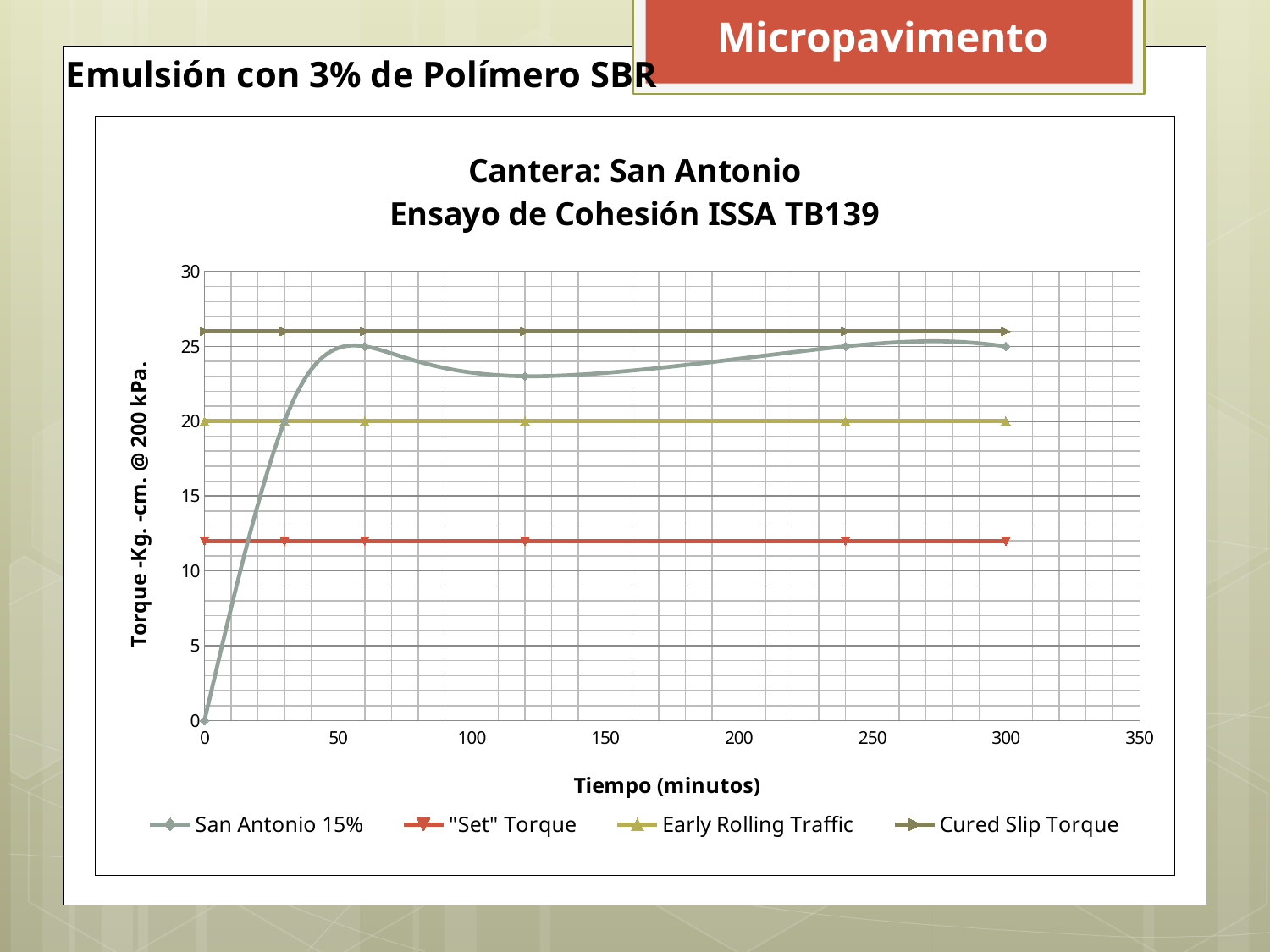
What is the value of the Early Rolling Traffic series at 120 minutes? 20 Is the value of the Cured Slip Torque series greater or less than 25? greater What is the label of the x axis? Tiempo (minutos) How many series does the legend list? 4 Which is larger at 120 minutes: the San Antonio 15% series or the "Set" Torque series? San Antonio 15% What kind of chart is shown on the slide? line chart Is the value of the "Set" Torque series greater or less than 15? less Which series has the highest values across the chart? Cured Slip Torque What is the value of the San Antonio 15% series at 0 minutes? 0 What is the title of the chart? Cantera: San Antonio Ensayo de Cohesión ISSA TB139 What is the value of the San Antonio 15% series at 30 minutes? 20 What is the value of the San Antonio 15% series at 60 minutes? 25